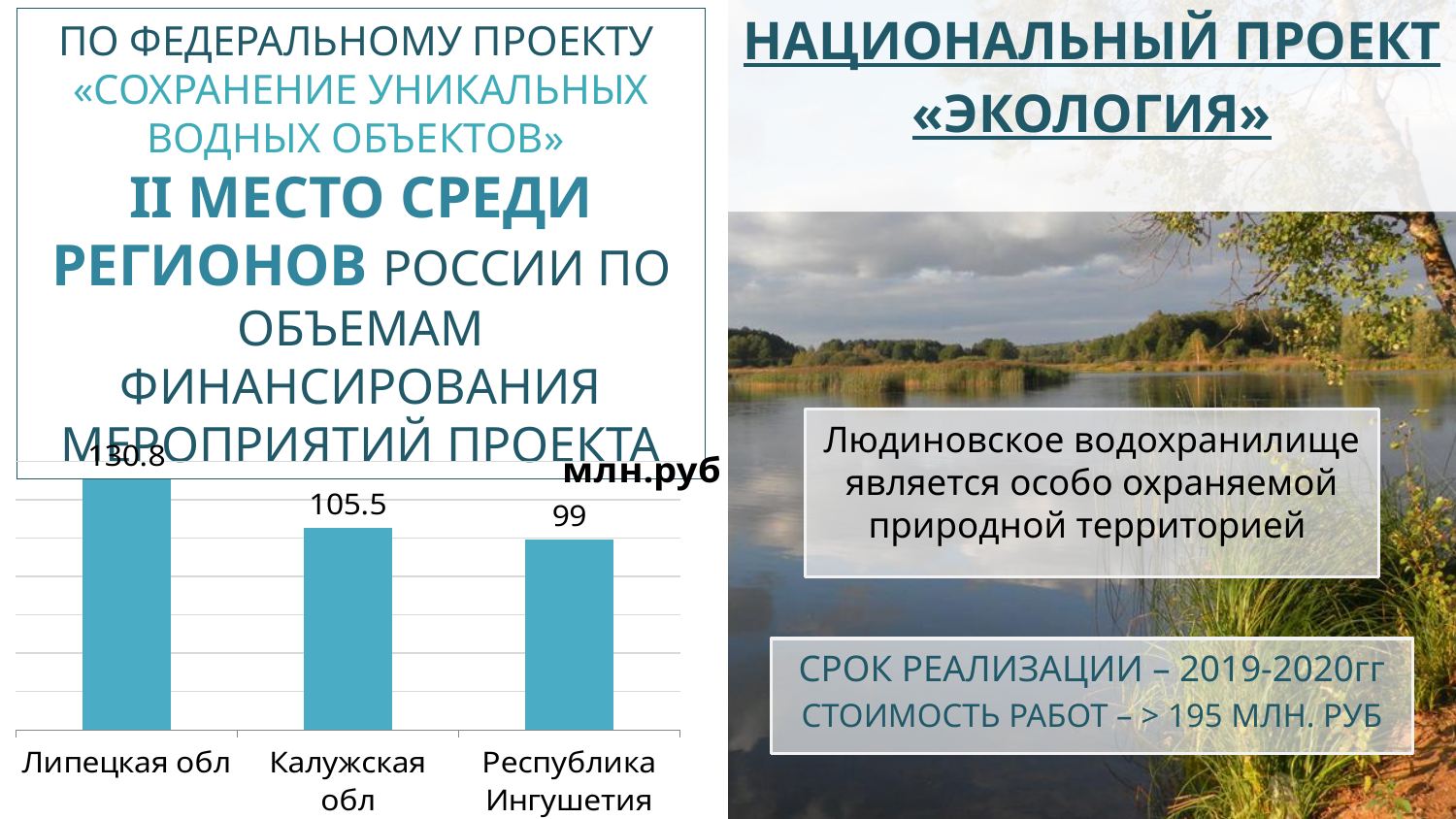
What is the value for Калужская обл on the chart? 105.5 Do the values rise or fall from left to right across the chart? fall What kind of chart is shown on the slide? bar chart What is the value for Республика Ингушетия on the chart? 99 What is the difference between the values for Калужская обл and Республика Ингушетия? 6.5 Which category has the highest value on the chart? Липецкая обл What is the difference between the values for Липецкая обл and Калужская обл? 25.3 Which category has the lowest value on the chart? Республика Ингушетия How many categories are shown on the chart? 3 What is the value for Липецкая обл on the chart? 130.8 Which is larger, the value for Калужская обл or the value for Республика Ингушетия? Калужская обл What unit is indicated for the values on the chart? млн.руб